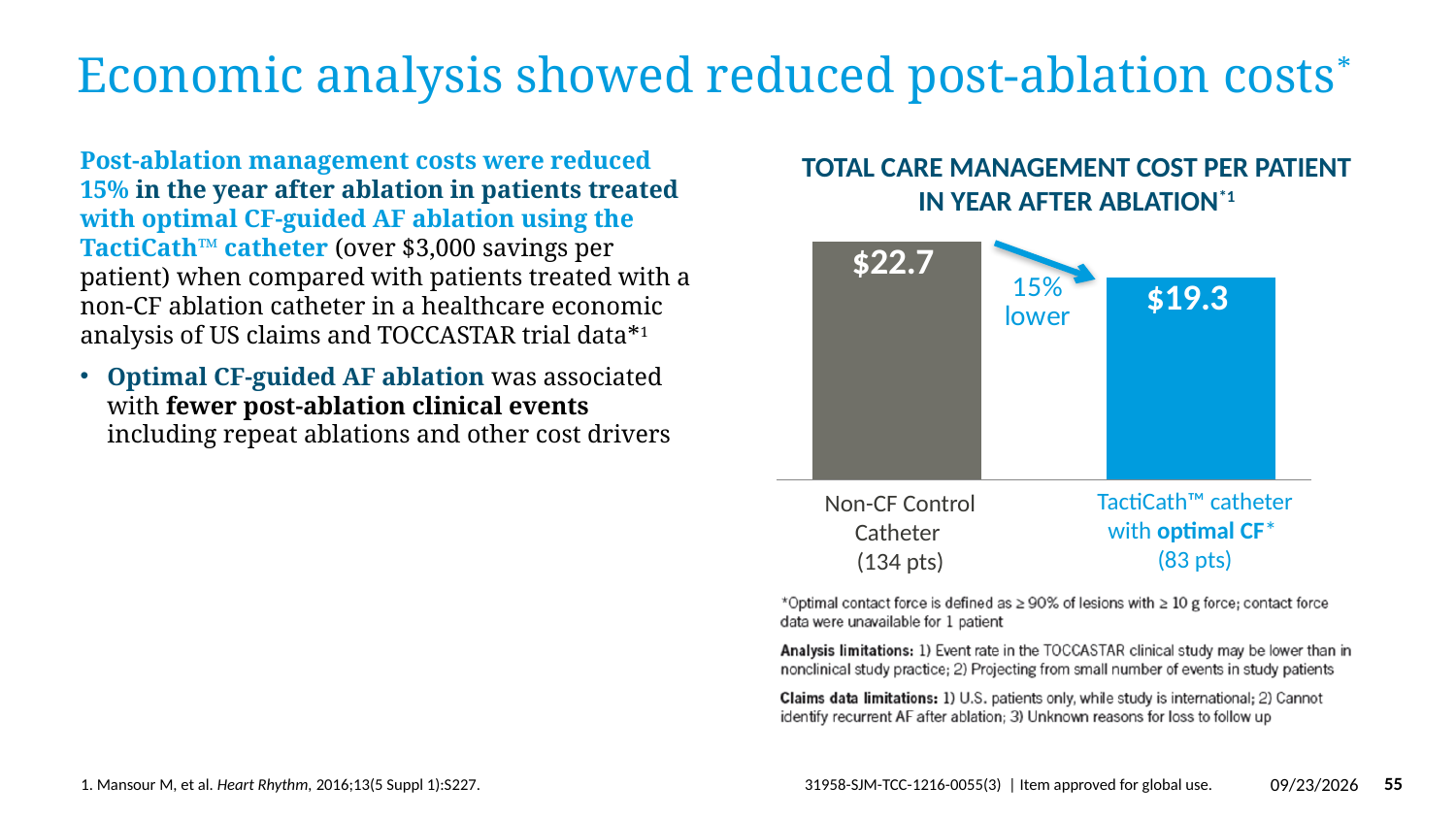
What is the total care management cost per patient for the Non-CF Control Catheter? $22.7 How many bars are shown in the chart? 2 How many patients are in the TactiCath catheter with optimal CF group? 83 pts Which catheter group has the lower total care management cost per patient? TactiCath catheter with optimal CF Is the cost per patient for the TactiCath catheter with optimal CF larger or smaller than for the Non-CF Control Catheter? smaller What is the total care management cost per patient for the TactiCath catheter with optimal CF? $19.3 What is the title of the chart? TOTAL CARE MANAGEMENT COST PER PATIENT IN YEAR AFTER ABLATION What type of chart is shown on the slide? bar chart How many patients are in the Non-CF Control Catheter group? 134 pts Which catheter group has the higher total care management cost per patient? Non-CF Control Catheter What is the difference in cost per patient between the Non-CF Control Catheter and the TactiCath catheter with optimal CF? $3.4 By what percentage is the TactiCath catheter with optimal CF cost lower than the Non-CF Control Catheter cost, according to the chart annotation? 15% lower